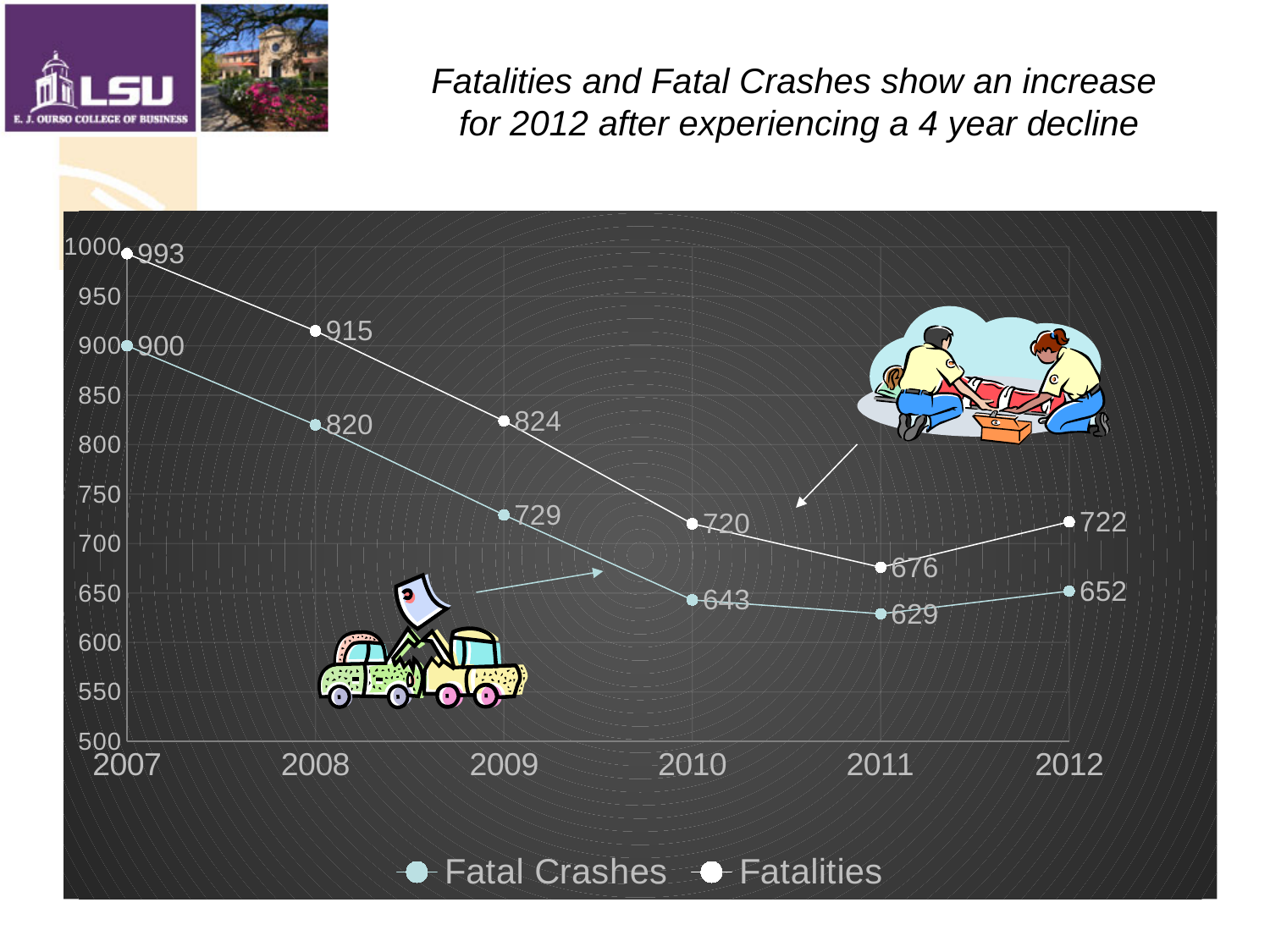
How many series does the legend list? 2 What is the value for Fatal Crashes in 2012? 652 In which year is the Fatal Crashes series highest? 2007 What is the value for Fatalities in 2007? 993 Which is larger in 2009, Fatalities or Fatal Crashes? Fatalities What kind of chart is shown on the slide? Line chart What is the difference between Fatalities and Fatal Crashes in 2010? 77 What are the two series named in the legend? Fatal Crashes and Fatalities What is the value for Fatal Crashes in 2011? 629 Do the Fatalities values rise or fall from 2007 to 2011? Fall How many years are shown on the x axis? 6 In which year is the Fatalities series lowest? 2011